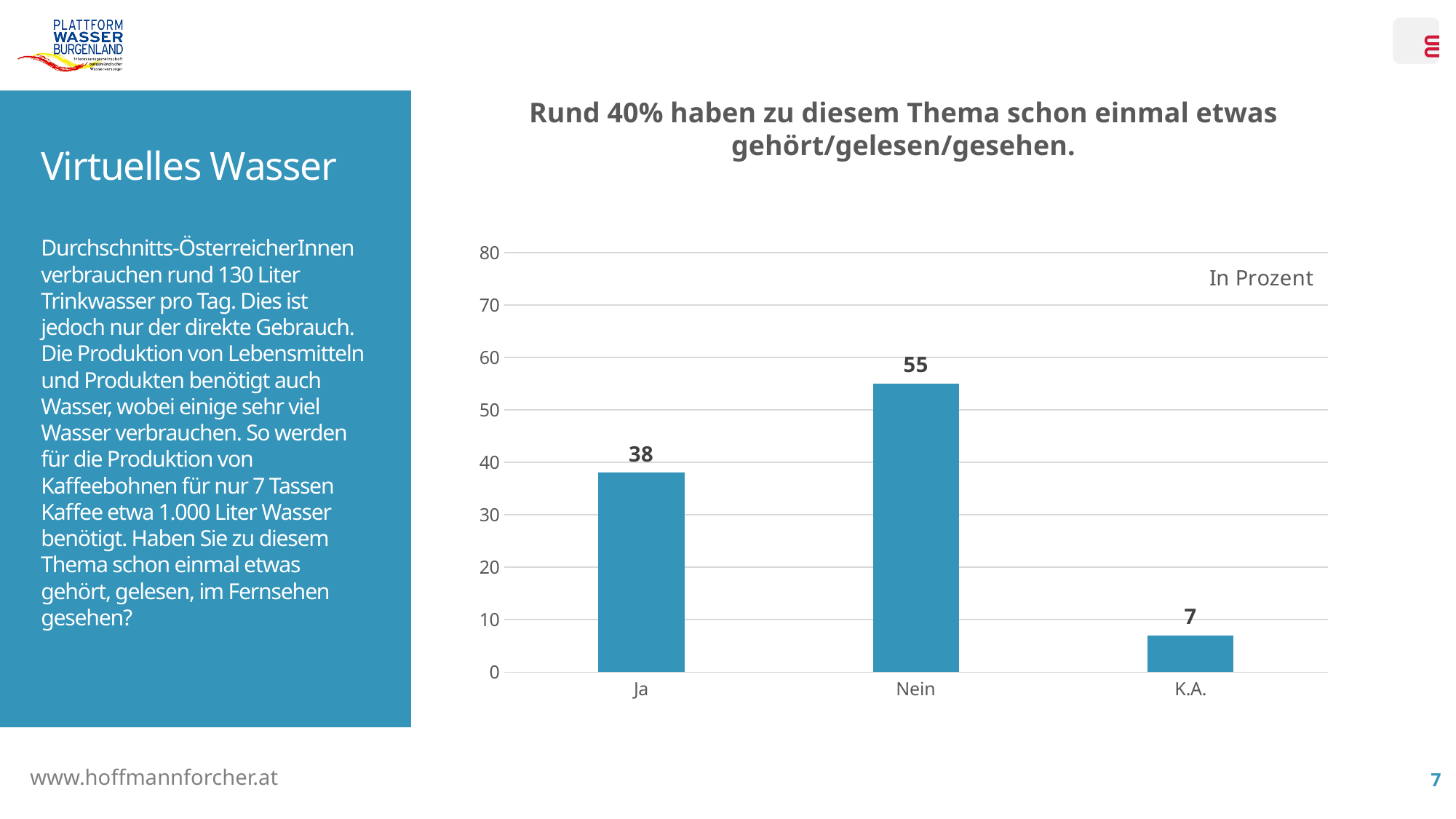
Which category has the lowest value? K.A. What unit label is shown in the top right of the chart area? In Prozent What is the difference between the values for Ja and K.A.? 31 What kind of chart is shown on the slide? bar chart What is the value for Ja? 38 What is the value for K.A.? 7 What is the difference between the values for Nein and Ja? 17 What is the value for Nein? 55 Which is larger, the value for Ja or the value for Nein? Nein Which category has the highest value? Nein Is the value for Nein greater or less than 50? greater How many categories are shown on the x axis? 3